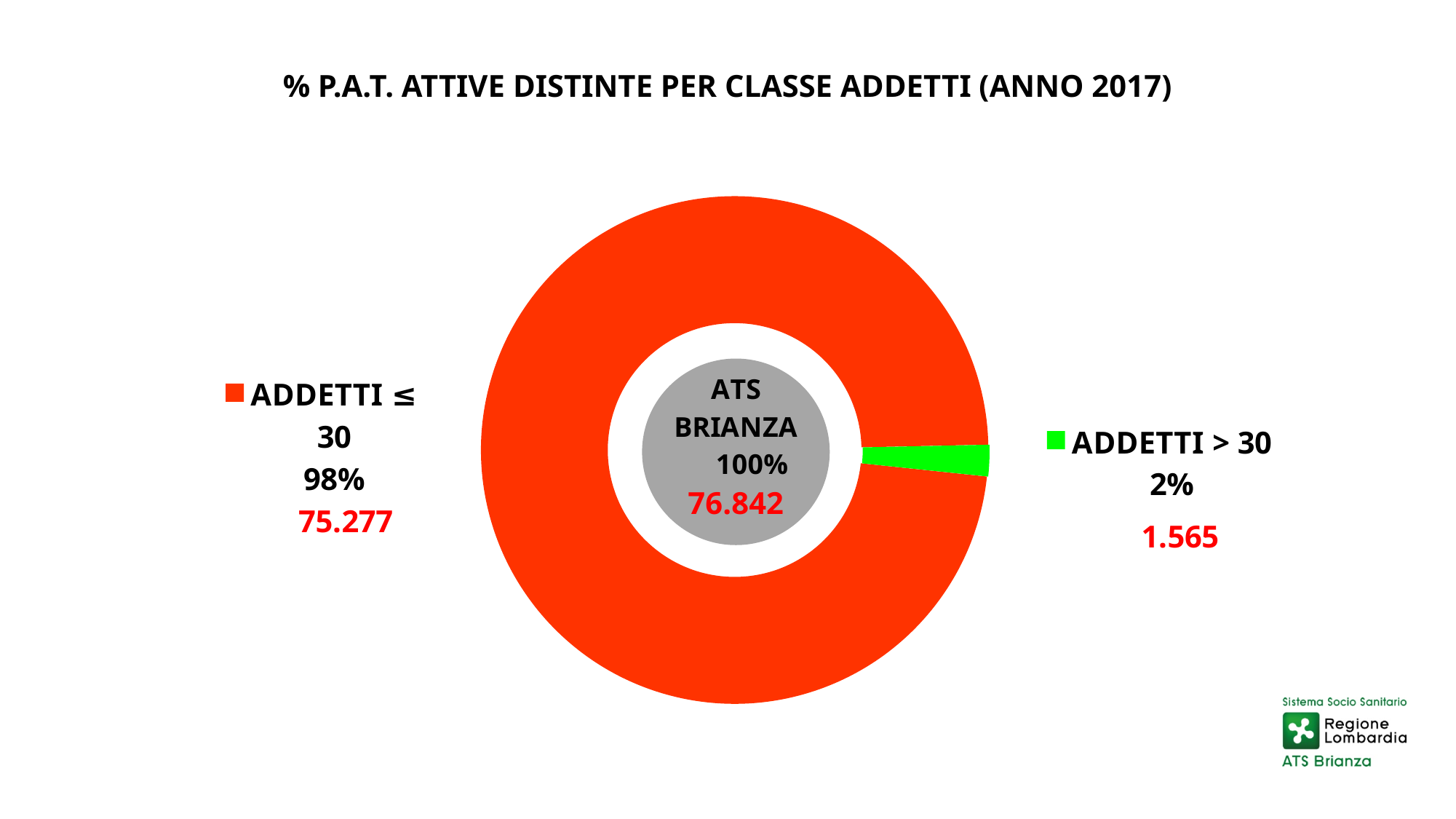
What total is shown in the centre of the chart for ATS BRIANZA? 76.842 What percentage of the chart does the ADDETTI > 30 slice represent? 2% What percentage of the chart does the ADDETTI ≤ 30 slice represent? 98% What is the difference between the counts for ADDETTI ≤ 30 and ADDETTI > 30? 73.712 Which is larger, the share for ADDETTI ≤ 30 or for ADDETTI > 30? ADDETTI ≤ 30 Which category has the largest share of the chart? ADDETTI ≤ 30 How many categories are shown in the chart? 2 What is the title of the chart? % P.A.T. ATTIVE DISTINTE PER CLASSE ADDETTI (ANNO 2017) What is the count shown for ADDETTI > 30? 1.565 What is the count shown for ADDETTI ≤ 30? 75.277 Which category has the smallest share of the chart? ADDETTI > 30 What kind of chart is shown on the slide? Pie chart (doughnut)